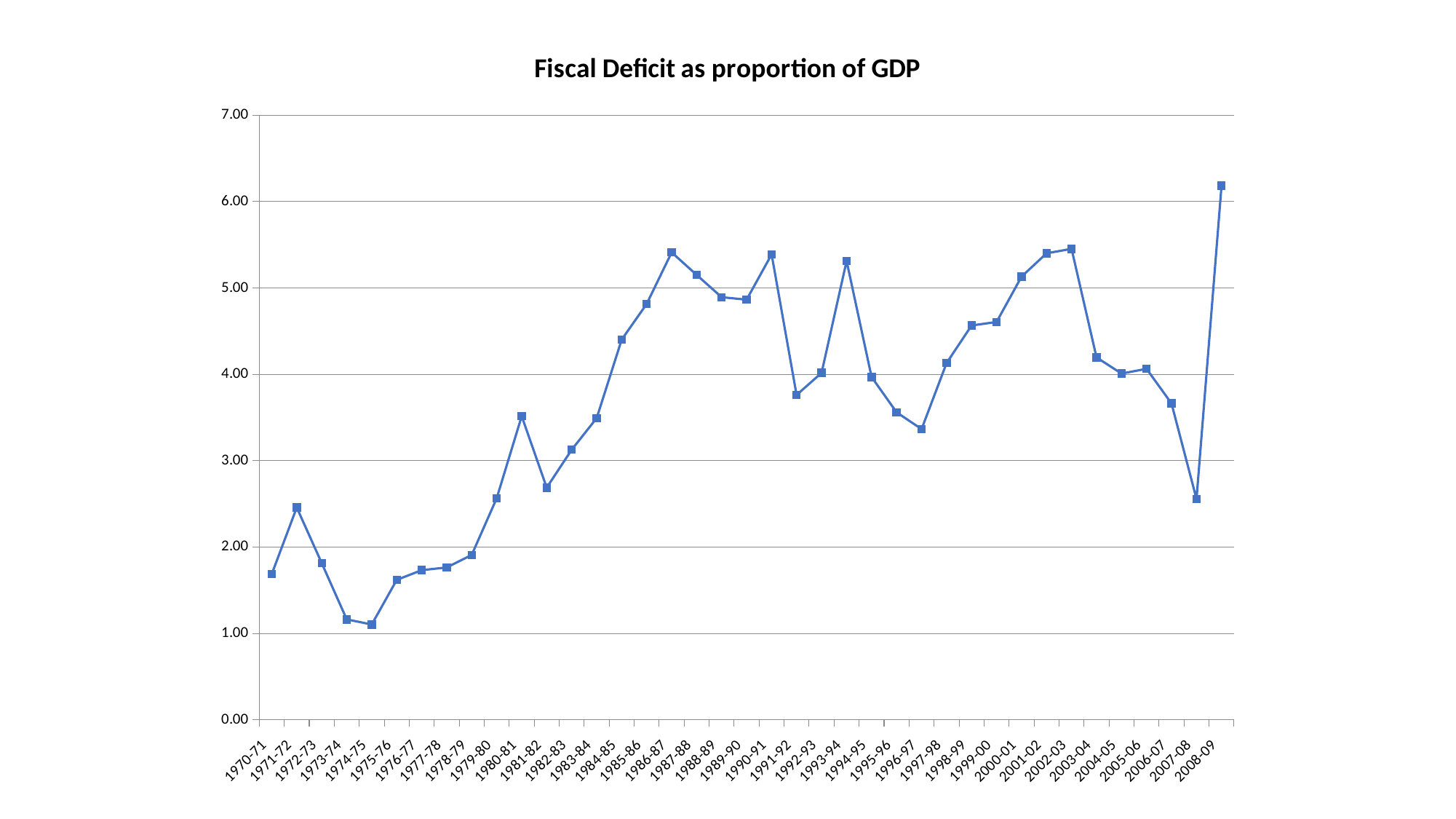
Is the value for 1991-92 greater or less than 4.00? less Which is larger, the value for 2002-03 or the value for 2007-08? 2002-03 Do the values generally rise or fall from 2002-03 to 2007-08? fall Is the value for 1974-75 greater or less than 2.00? less Is the value for 2008-09 greater or less than 6.00? greater Which is larger, the value for 1986-87 or the value for 1991-92? 1986-87 How many years (data points) are plotted on the chart? 39 Which year has the highest fiscal deficit as a proportion of GDP? 2008-09 What is the title of the chart? Fiscal Deficit as proportion of GDP What kind of chart is shown on the slide? line chart